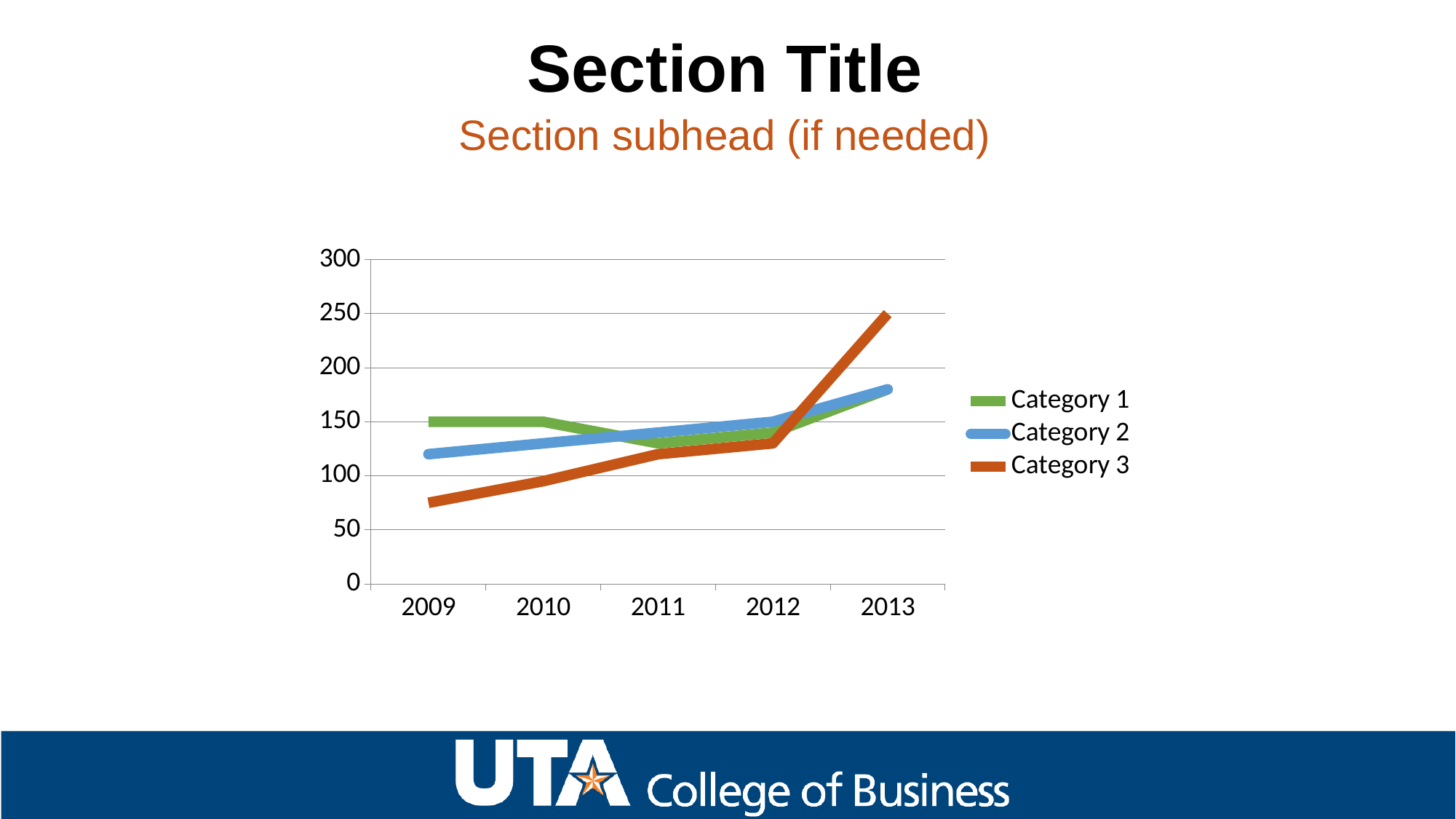
Does Category 3 rise or fall from 2009 to 2013? rise Which series has the highest value in 2009? Category 1 Is the value for Category 3 in 2013 greater or less than 200? greater What colour is the line for Category 2? blue Is the value for Category 1 in 2013 greater or less than 200? less Which series has the lowest value in 2009? Category 3 How many years are shown on the x axis? 5 Which series has the highest value in 2013? Category 3 Which is larger in 2010, Category 1 or Category 3? Category 1 What kind of chart is shown on the slide? line chart How many series does the legend list? 3 Is the value for Category 3 in 2009 greater or less than 100? less